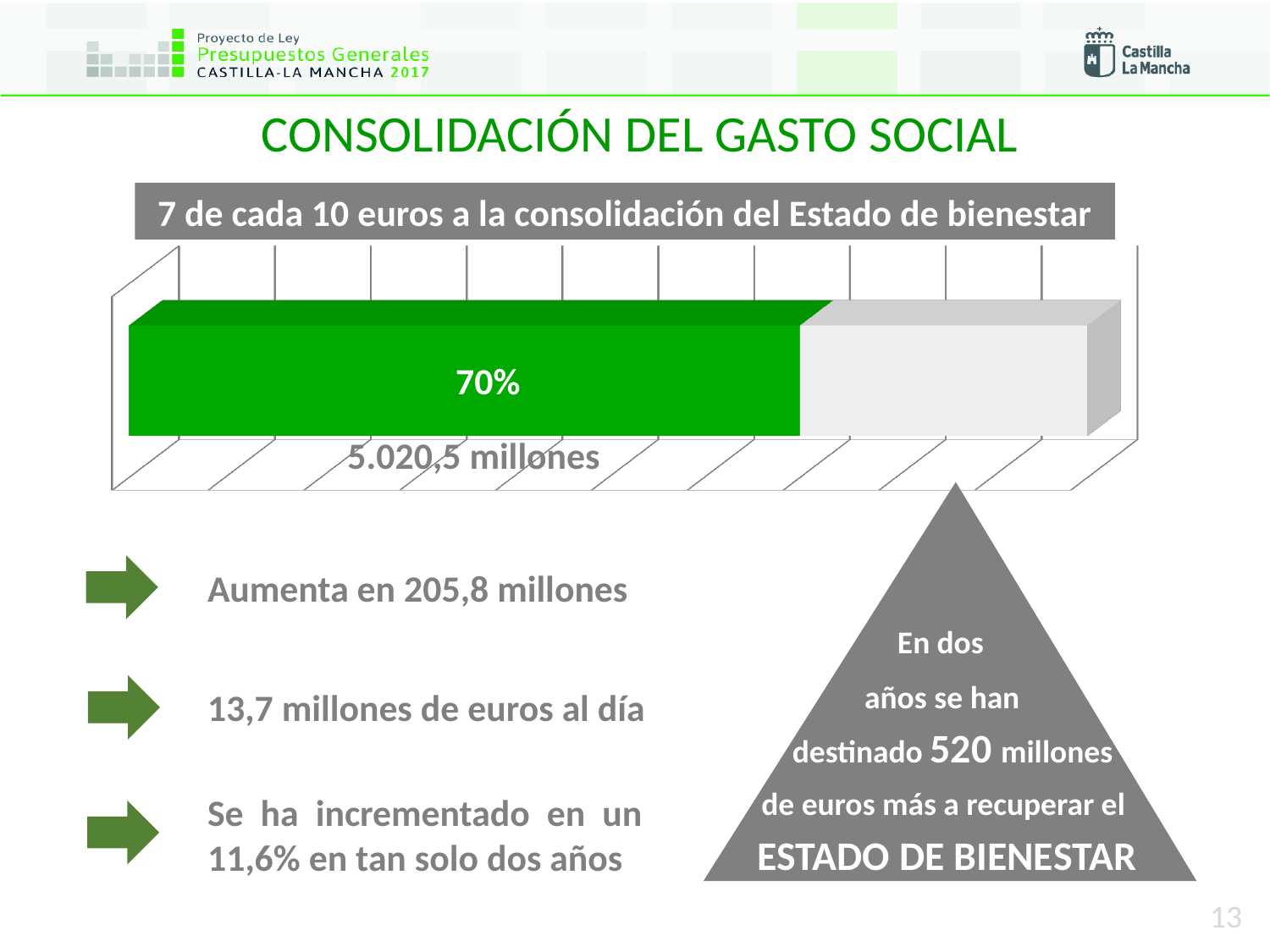
Which segment of the bar is larger, the green one or the grey one? the green one How many segments does the bar have? 2 What percentage is printed on the green segment of the bar? 70% What is the heading printed in the grey box above the bar chart? 7 de cada 10 euros a la consolidación del Estado de bienestar What amount in millions is printed below the green segment of the bar? 5.020,5 millones What kind of chart is shown on the slide? bar chart Is the value shown on the green segment greater or less than 50%? greater What colour is the segment labelled 70%? green